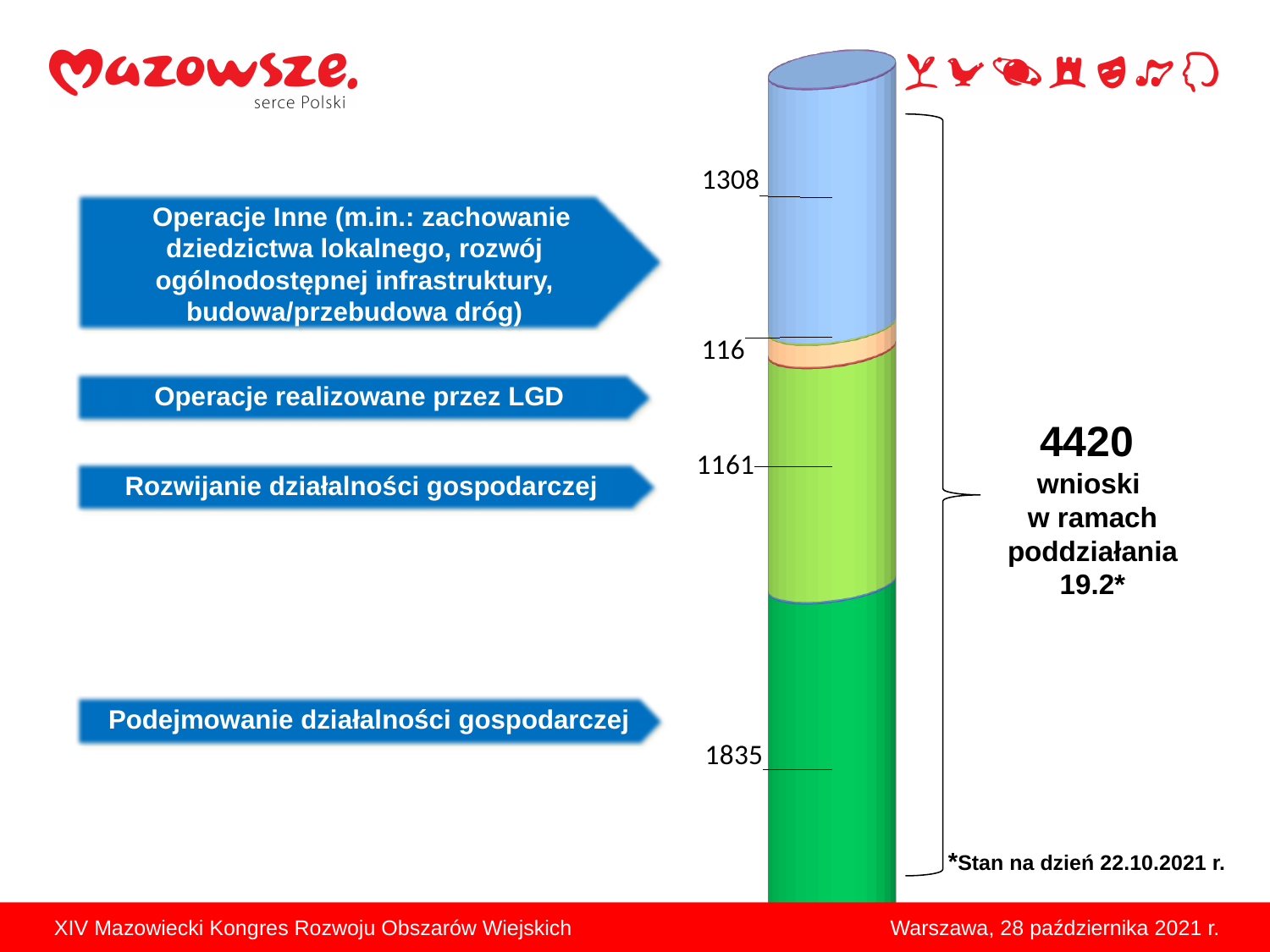
Which is larger: Operacje Inne or Rozwijanie działalności gospodarczej? Operacje Inne What is the value for Podejmowanie działalności gospodarczej? 1835 What is the value for Operacje realizowane przez LGD? 116 What is the value for the Operacje Inne segment? 1308 Which category has the lowest value? Operacje realizowane przez LGD What is the value for Rozwijanie działalności gospodarczej? 1161 What kind of chart is shown on the slide? Stacked bar chart What colour is the segment for Podejmowanie działalności gospodarczej? Green How many segments does the stacked bar have? 4 Which category has the highest value? Podejmowanie działalności gospodarczej What is the difference between Podejmowanie działalności gospodarczej and Rozwijanie działalności gospodarczej? 674 What is the total of the stacked bar? 4420